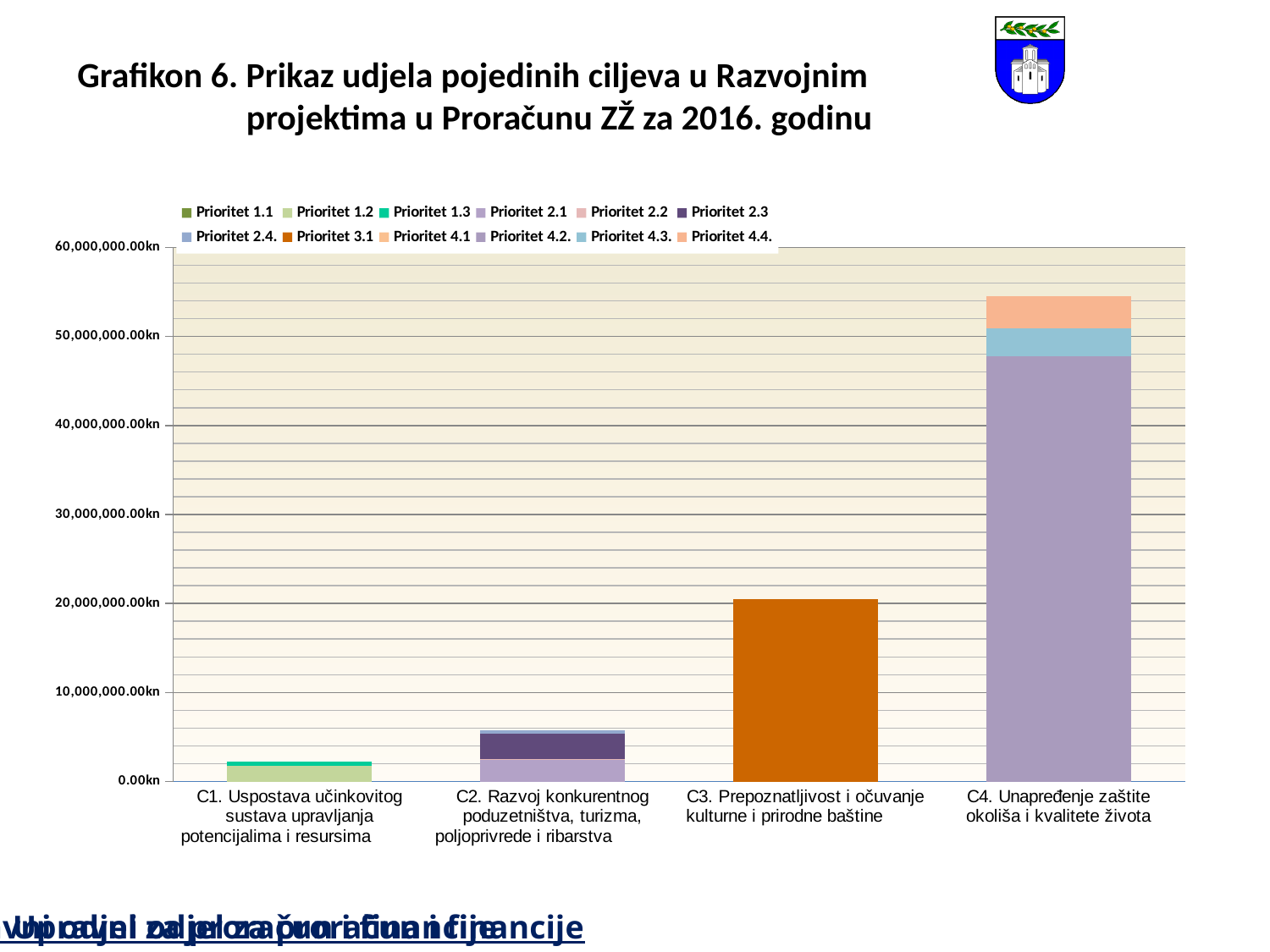
Which legend series is the orange bar for C3 made up of? Prioritet 3.1 How many series does the chart legend list? 12 Which category has the tallest stacked bar? C4. Unapređenje zaštite okoliša i kvalitete života Which bar is taller: C3. Prepoznatljivost i očuvanje kulturne i prirodne baštine or C2. Razvoj konkurentnog poduzetništva, turizma, poljoprivrede i ribarstva? C3. Prepoznatljivost i očuvanje kulturne i prirodne baštine What kind of chart is shown on the slide? Stacked bar chart Which category has the shortest stacked bar? C1. Uspostava učinkovitog sustava upravljanja potencijalima i resursima Which bar is taller: C1 or C2? C2. Razvoj konkurentnog poduzetništva, turizma, poljoprivrede i ribarstva How many categories (ciljevi) are shown on the x axis of the chart? 4 Is the total value for C4. Unapređenje zaštite okoliša i kvalitete života greater or less than 50,000,000.00kn? greater Is the total value for C2. Razvoj konkurentnog poduzetništva, turizma, poljoprivrede i ribarstva greater or less than 10,000,000.00kn? less Is the total value for C3. Prepoznatljivost i očuvanje kulturne i prirodne baštine greater or less than 30,000,000.00kn? less What is the title of the chart on the slide? Grafikon 6. Prikaz udjela pojedinih ciljeva u Razvojnim projektima u Proračunu ZŽ za 2016. godinu